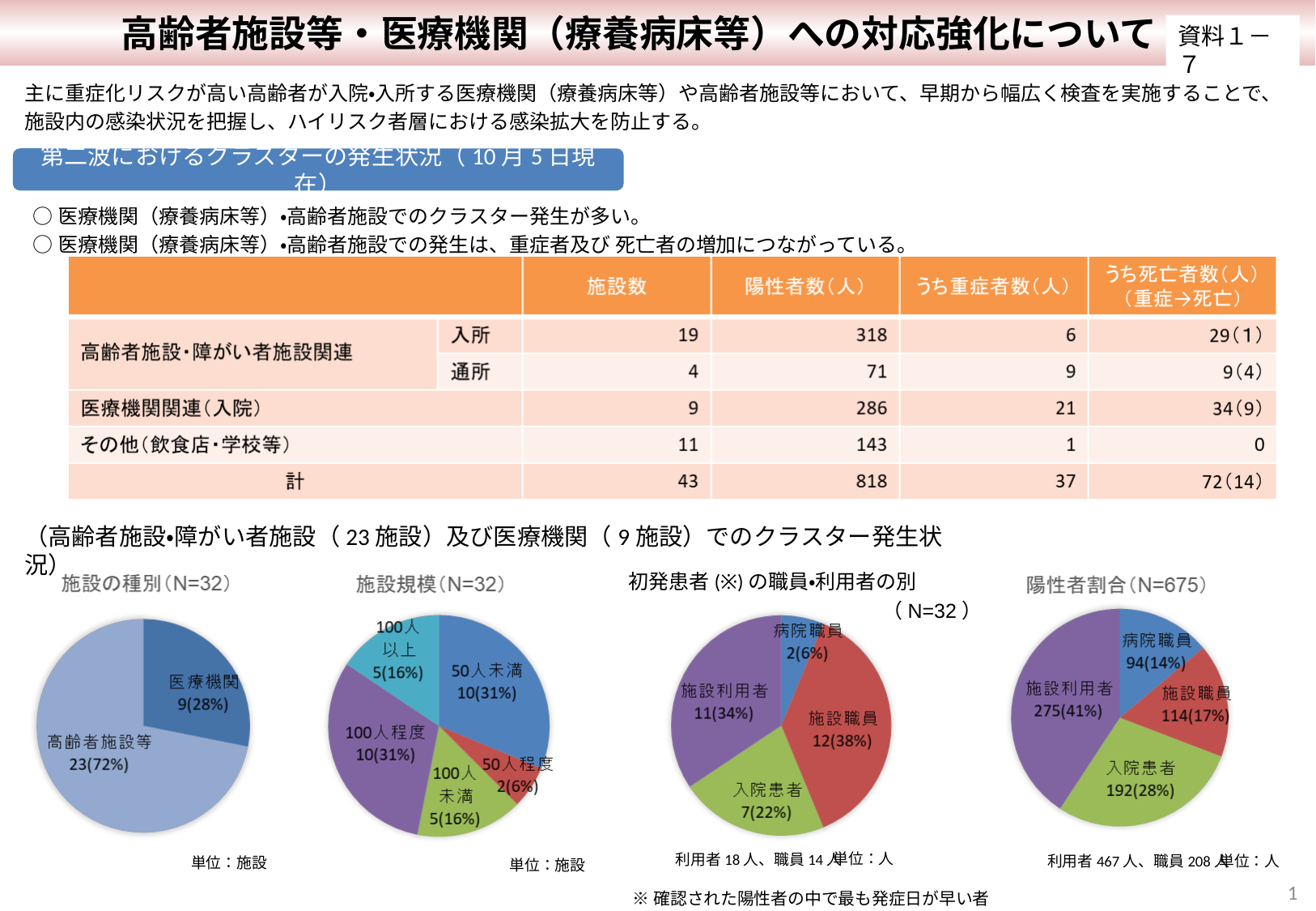
In the 陽性者割合(N=675) pie chart, which category has the smallest value? 病院職員 In the 施設の種別(N=32) pie chart, what share of the pie does 医療機関 represent? 28% In the 初発患者(※)の職員・利用者の別(N=32) pie chart, what is the difference in count between 施設利用者 and 病院職員? 9 In the 施設規模(N=32) pie chart, what is the value shown for 100人以上? 5(16%) In the 陽性者割合(N=675) pie chart, which is larger, 入院患者 or 施設職員? 入院患者 What kind of chart is the 施設規模(N=32) chart? Pie chart In the 施設の種別(N=32) pie chart, what is the value shown for 高齢者施設等? 23(72%) In the 施設規模(N=32) pie chart, which category has the smallest value? 50人程度 In the 陽性者割合(N=675) pie chart, what is the value shown for 施設利用者? 275(41%) How many categories are shown in the 施設規模(N=32) pie chart? 5 In the 初発患者(※)の職員・利用者の別(N=32) pie chart, which category has the largest value? 施設職員 In the 初発患者(※)の職員・利用者の別(N=32) pie chart, what is the value shown for 入院患者? 7(22%)